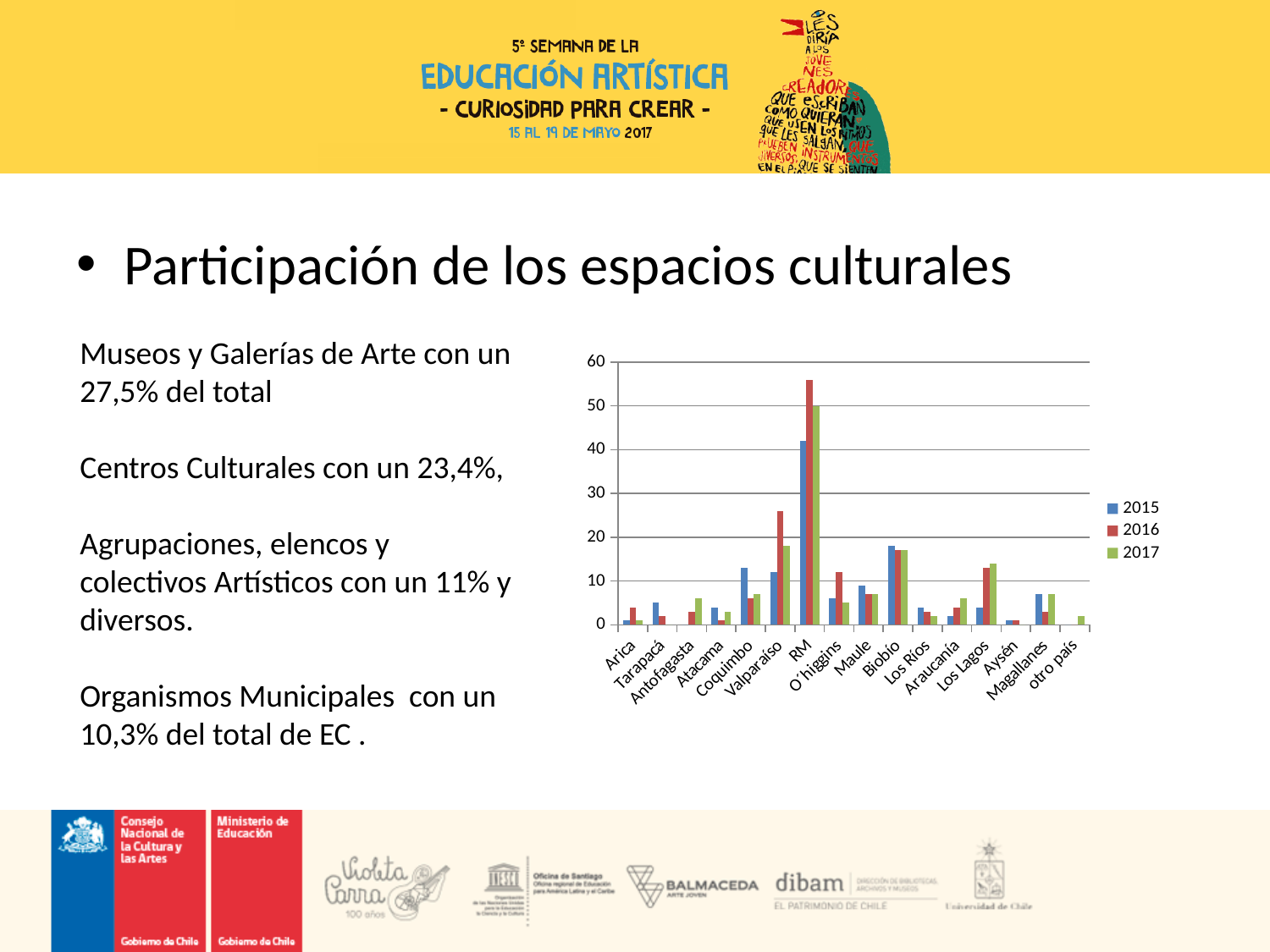
Is the 2016 value for RM greater or less than 50? greater Is the 2016 value for Valparaíso greater or less than 20? greater Is the 2015 value for RM greater or less than 30? greater What kind of chart is shown on the slide? bar chart For 2016, which is larger: Valparaíso or Coquimbo? Valparaíso For Valparaíso, which year has the tallest bar? 2016 What are the entries listed in the chart legend? 2015, 2016, 2017 Which category has the highest 2016 bar in the chart? RM How many categories are shown along the x axis of the chart? 16 How many series does the chart legend list? 3 For RM, which is larger: the 2015 value or the 2016 value? 2016